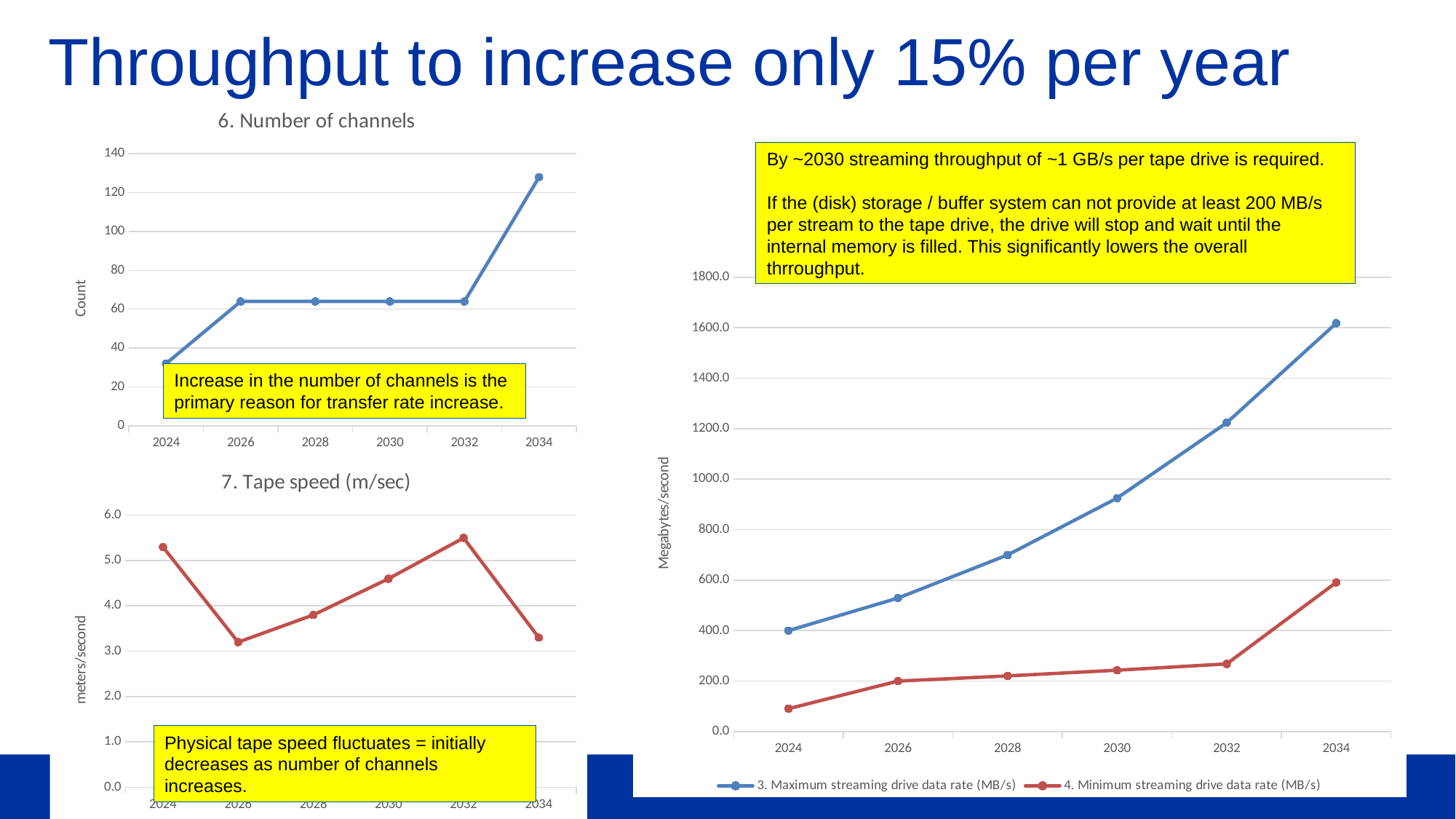
How many years are plotted on the '7. Tape speed (m/sec)' chart? 6 On the chart on the right side of the slide, is the 2024 value for '4. Minimum streaming drive data rate (MB/s)' greater or less than 200.0? less On the '6. Number of channels' chart, is the value for 2024 greater or less than 40? less On the chart on the right side of the slide, does the '3. Maximum streaming drive data rate (MB/s)' series rise or fall from 2024 to 2034? rise On the '6. Number of channels' chart, is the value for 2034 greater or less than 120? greater On the '7. Tape speed (m/sec)' chart, which is larger, the value for 2030 or the value for 2028? 2030 On the '6. Number of channels' chart, which year has the lowest number of channels? 2024 How many series does the legend of the chart on the right side of the slide list? 2 On the '6. Number of channels' chart, which year has the highest number of channels? 2034